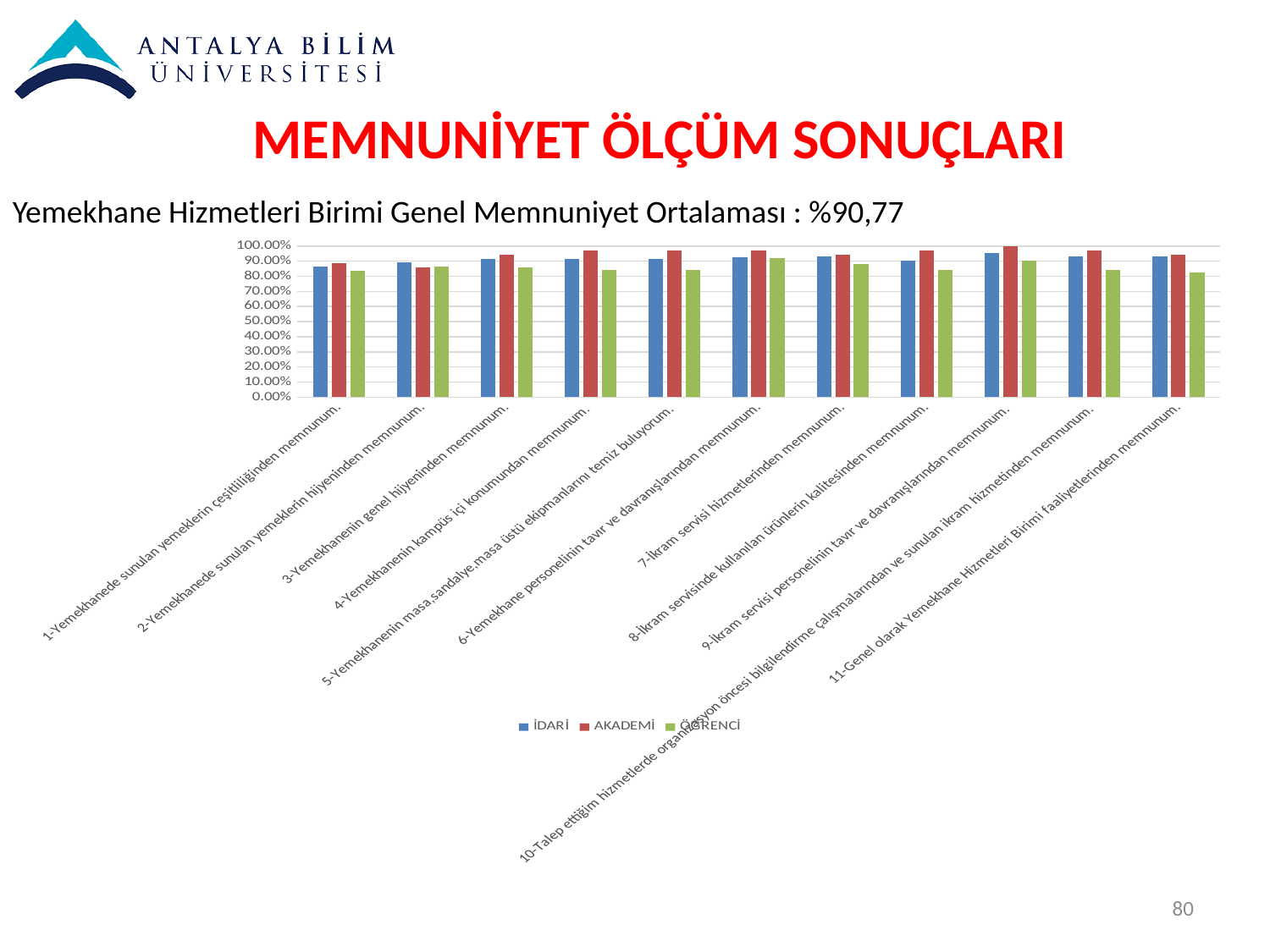
What overall satisfaction average for Yemekhane Hizmetleri Birimi is stated above the chart? %90,77 For item 9 (İkram servisi personelinin tavır ve davranışlarından memnunum), which series has the highest bar? AKADEMİ For item 10 (Talep ettiğim hizmetlerde organizasyon öncesi bilgilendirme çalışmalarından ve sunulan ikram hizmetinden memnunum), which series has the lowest bar? ÖĞRENCİ What kind of chart is shown on the slide? bar chart For item 4 (Yemekhanenin kampüs içi konumundan memnunum), which is larger: the AKADEMİ value or the ÖĞRENCİ value? AKADEMİ Is the ÖĞRENCİ value for item 4 (Yemekhanenin kampüs içi konumundan memnunum) greater or less than 90.00%? less How many categories (survey items) are shown on the x axis? 11 Is the İDARİ value for item 1 (Yemekhanede sunulan yemeklerin çeşitliliğinden memnunum) greater or less than 90.00%? less Is the AKADEMİ value for item 4 (Yemekhanenin kampüs içi konumundan memnunum) greater or less than 90.00%? greater Which series are listed in the legend? İDARİ, AKADEMİ, ÖĞRENCİ How many series does the legend list? 3